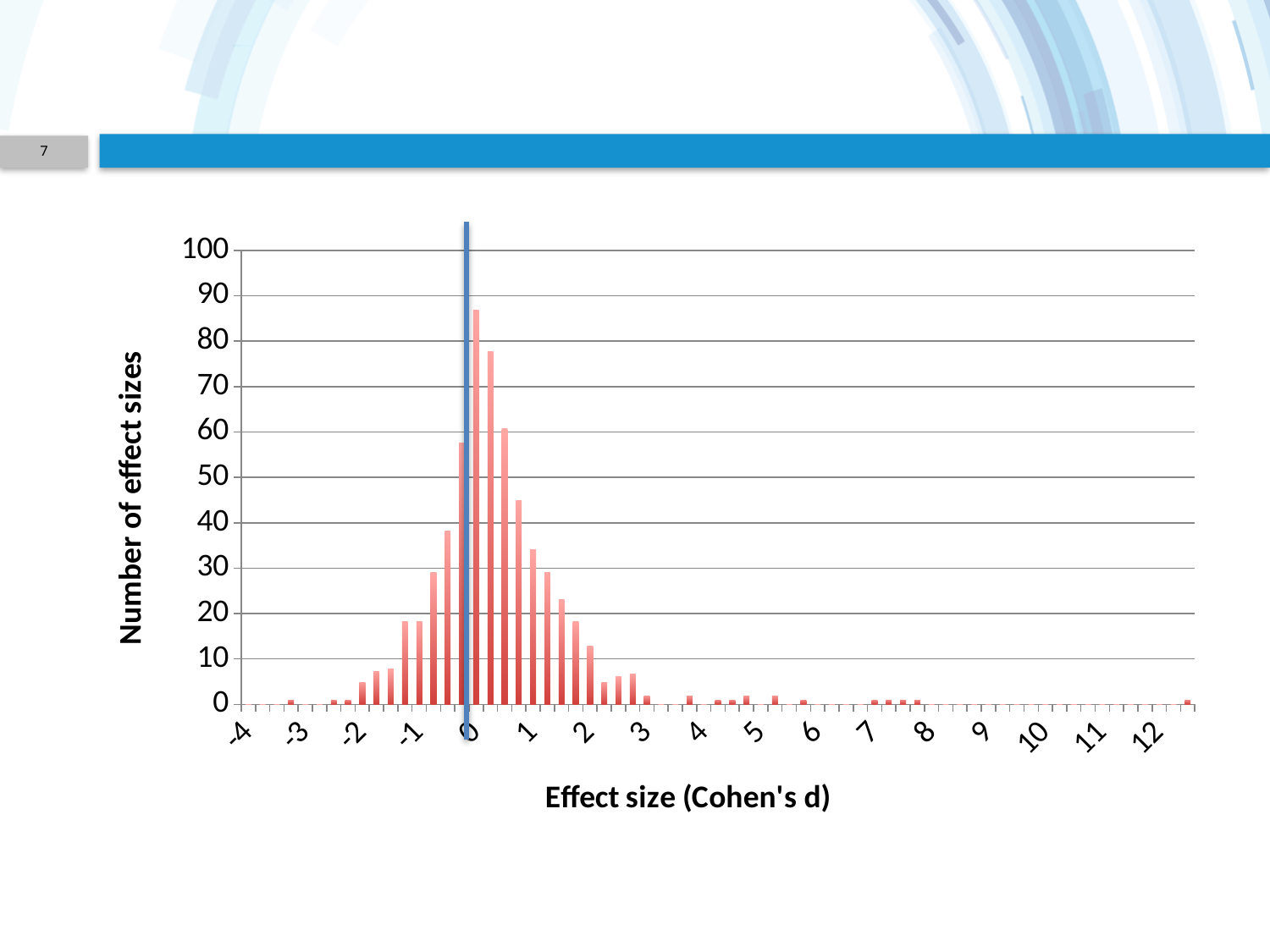
What is the lowest label shown on the x axis? -4 How many labelled tick values are there on the x axis? 17 Do the bar heights rise or fall as the effect size increases from 1 to 3? fall What is the highest label shown on the x axis? 12 What kind of chart is shown on the slide? Bar chart At which x-axis value is the vertical blue line drawn? 0 Do the bar heights rise or fall as the effect size increases from -2 to 0? rise What is the title of the x axis? Effect size (Cohen's d) What is the highest value shown on the y axis? 100 Is the tallest bar greater or less than 80? greater What is the title of the y axis? Number of effect sizes